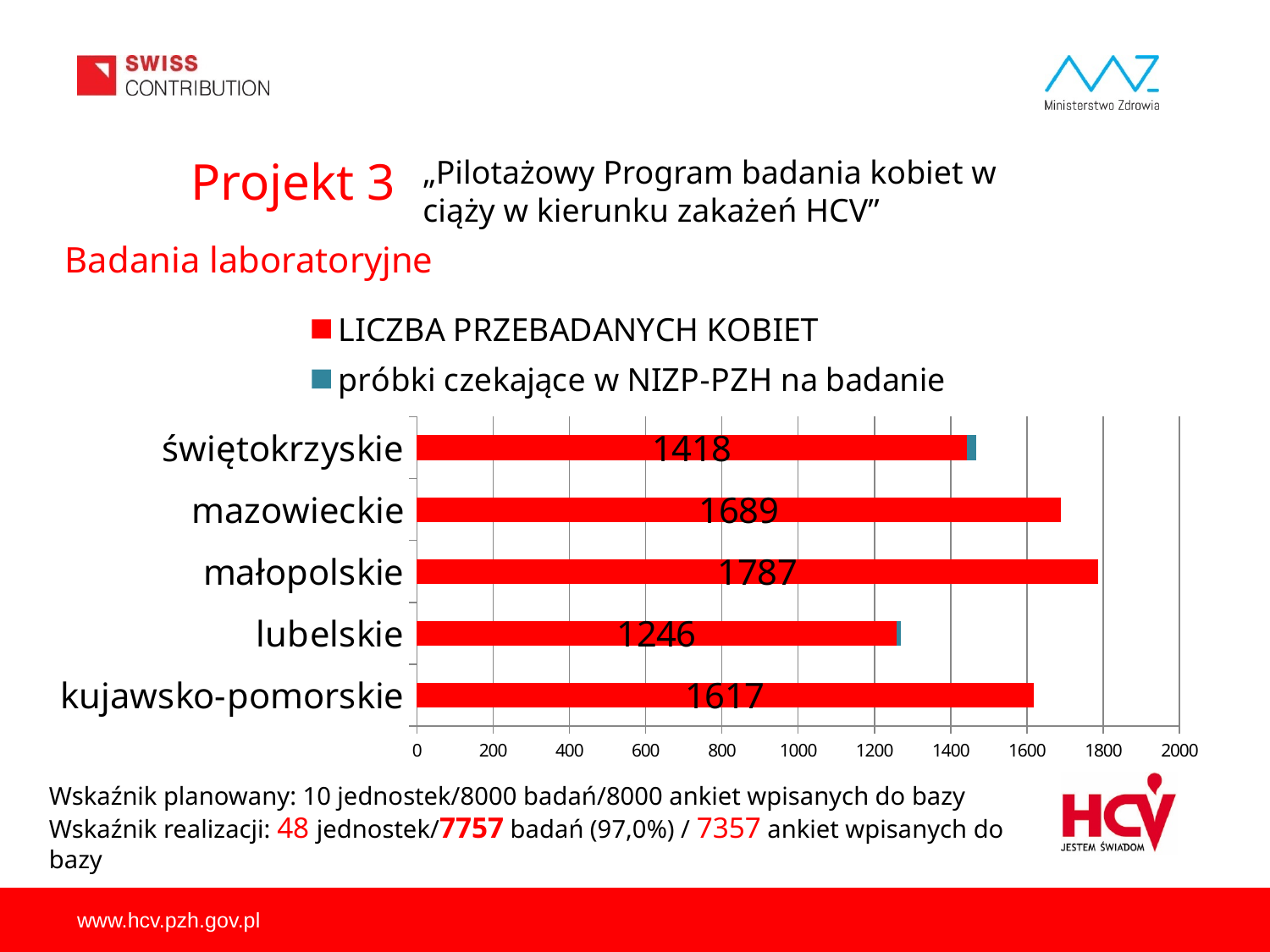
What is the value of LICZBA PRZEBADANYCH KOBIET for małopolskie? 1787 What kind of chart is shown on the slide? bar chart How many voivodeships are shown on the chart? 5 What is the difference in LICZBA PRZEBADANYCH KOBIET between mazowieckie and kujawsko-pomorskie? 72 Which has a larger LICZBA PRZEBADANYCH KOBIET, świętokrzyskie or mazowieckie? mazowieckie What is the difference in LICZBA PRZEBADANYCH KOBIET between małopolskie and lubelskie? 541 What is the value of LICZBA PRZEBADANYCH KOBIET for kujawsko-pomorskie? 1617 Which voivodeship has the highest LICZBA PRZEBADANYCH KOBIET? małopolskie Is the LICZBA PRZEBADANYCH KOBIET for świętokrzyskie greater or less than 1600? less What is the value of LICZBA PRZEBADANYCH KOBIET for lubelskie? 1246 Which voivodeship has the lowest LICZBA PRZEBADANYCH KOBIET? lubelskie How many series does the chart legend list? 2